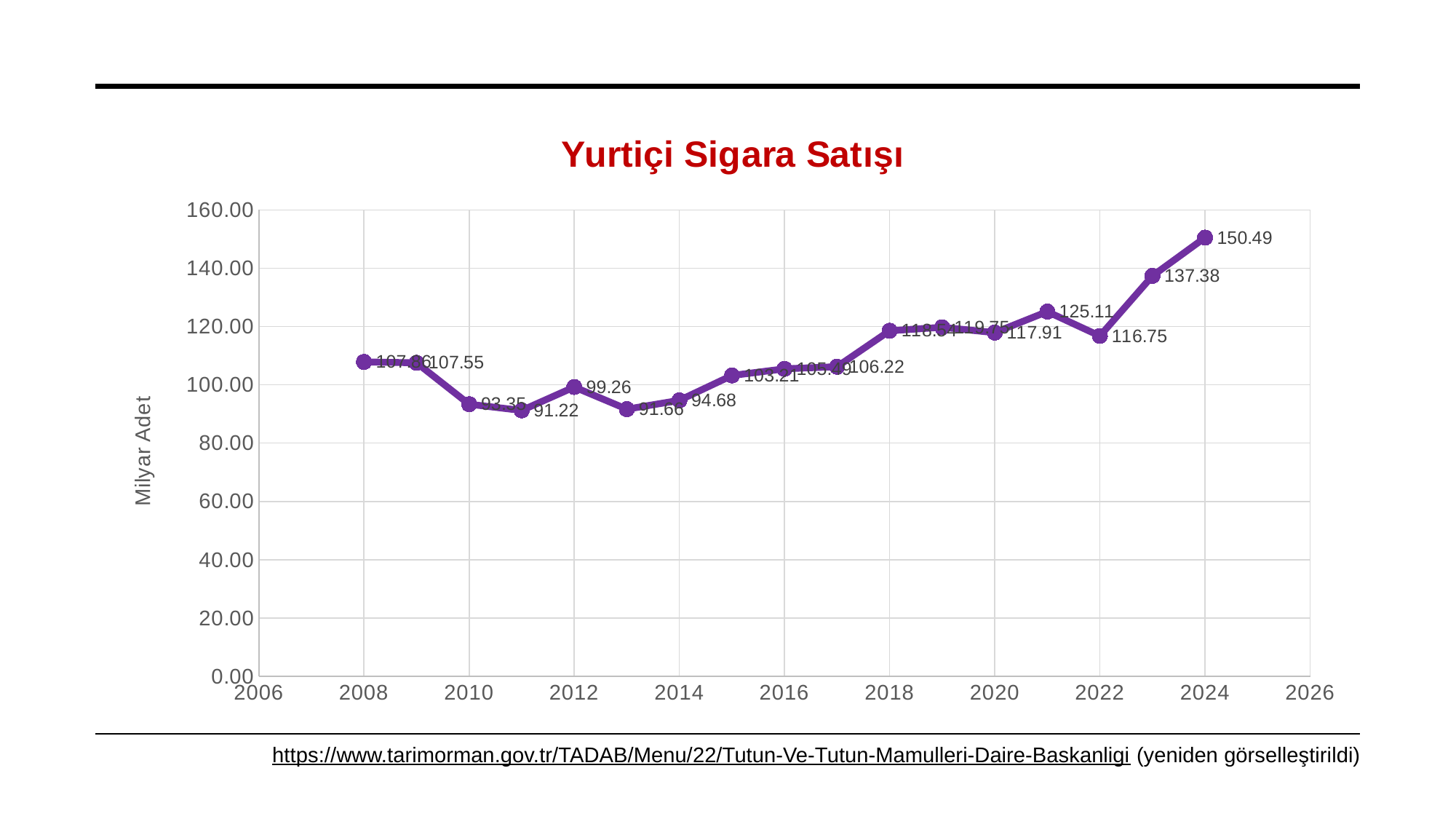
Which year has the highest value? 2024 How many data points are plotted on the chart? 17 What is the difference between the values for 2024 and 2023? 13.11 Is the value for 2008 greater or less than 100.00? greater What kind of chart is shown? line chart What is the value for 2011? 91.22 What is the value for 2024? 150.49 What is the value for 2012? 99.26 Which is larger, the value for 2021 or the value for 2022? 2021 Do the values rise or fall from 2022 to 2024? rise Which year has the lowest value? 2011 What is the value for 2023? 137.38